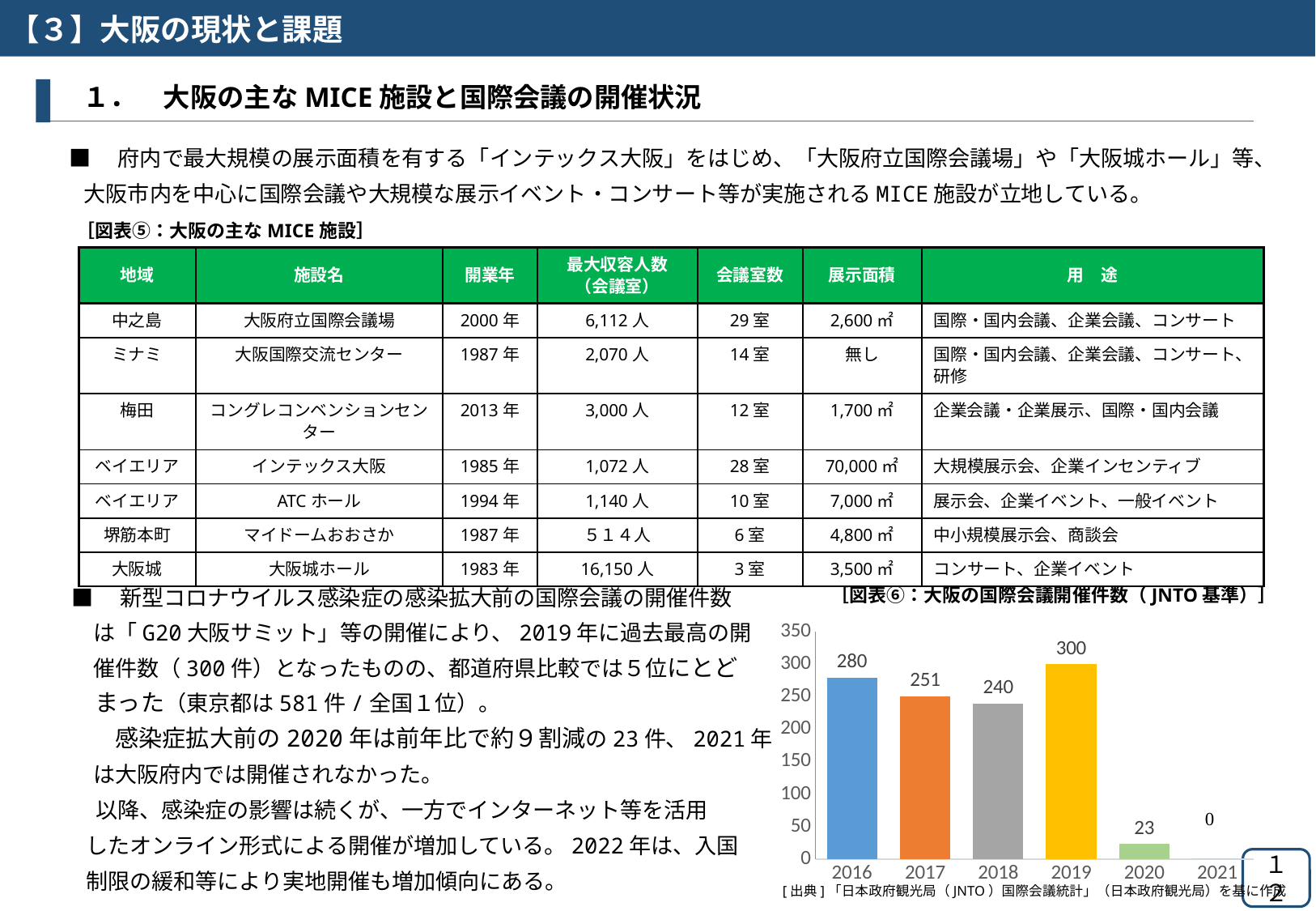
What is the value for 2020 in the chart 大阪の国際会議開催件数（JNTO基準）? 23 What kind of chart is 大阪の国際会議開催件数（JNTO基準）? bar chart What is the difference between the values for 2017 and 2018 in the chart 大阪の国際会議開催件数（JNTO基準）? 11 Which year has the lowest value in the chart 大阪の国際会議開催件数（JNTO基準）? 2021 In the chart 大阪の国際会議開催件数（JNTO基準）, which is larger, the value for 2016 or the value for 2017? 2016 What is the difference between the values for 2019 and 2020 in the chart 大阪の国際会議開催件数（JNTO基準）? 277 What is the value for 2019 in the chart 大阪の国際会議開催件数（JNTO基準）? 300 How many years are shown on the x axis of the chart 大阪の国際会議開催件数（JNTO基準）? 6 Which year has the highest value in the chart 大阪の国際会議開催件数（JNTO基準）? 2019 What is the value for 2021 in the chart 大阪の国際会議開催件数（JNTO基準）? 0 In the chart 大阪の国際会議開催件数（JNTO基準）, do the values rise or fall from 2019 to 2021? fall What is the value for 2016 in the chart 大阪の国際会議開催件数（JNTO基準）? 280